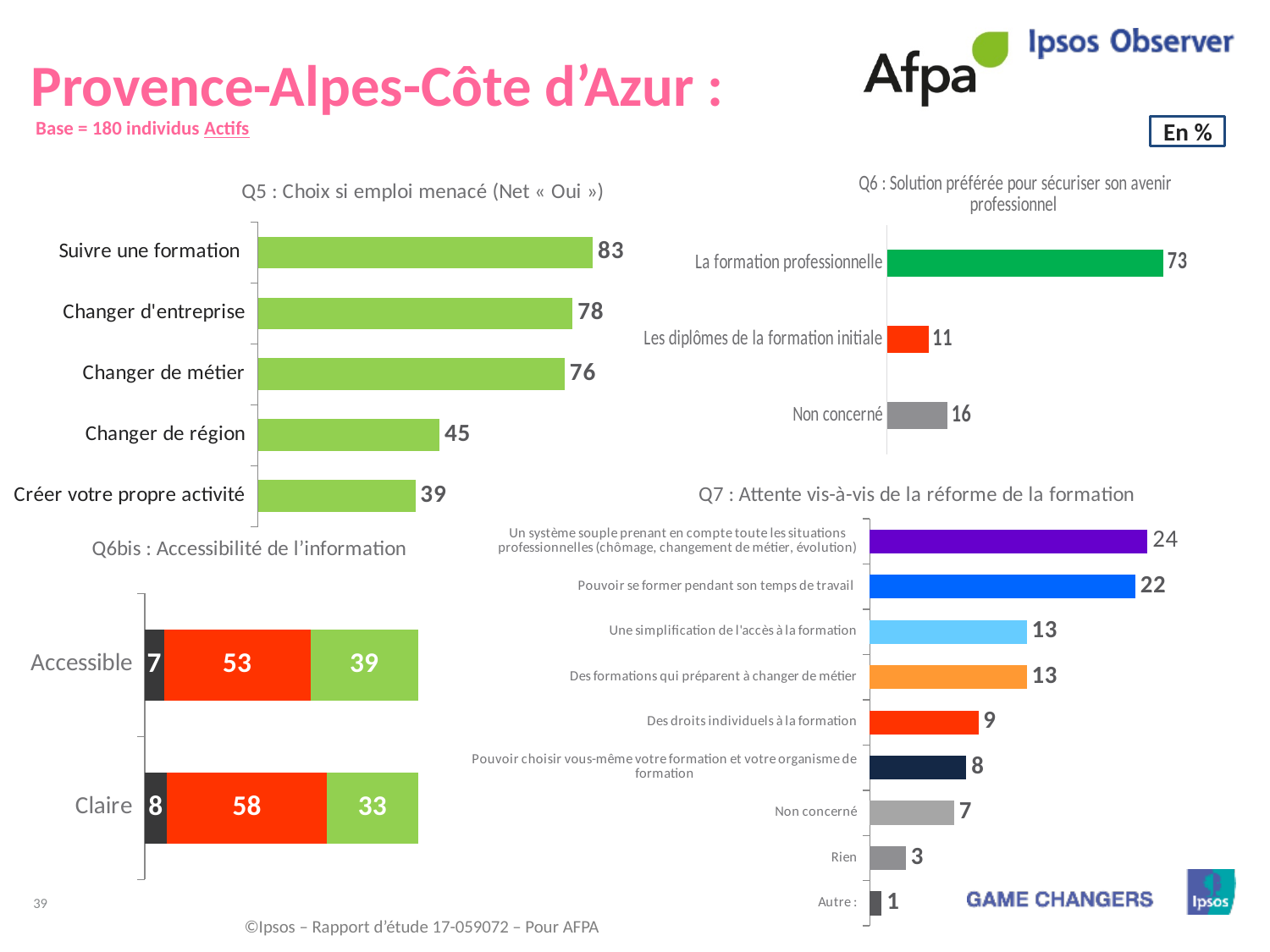
In the Q7 chart (Attente vis-à-vis de la réforme de la formation), what is the value for Des droits individuels à la formation? 9 In the Q6 chart (Solution préférée pour sécuriser son avenir professionnel), what is the value for Non concerné? 16 In the Q6 chart (Solution préférée pour sécuriser son avenir professionnel), which category has the lowest value? Les diplômes de la formation initiale In the Q6bis chart (Accessibilité de l'information), what is the value of the green segment for Claire? 33 In the Q7 chart (Attente vis-à-vis de la réforme de la formation), how many categories are shown? 9 In the Q7 chart (Attente vis-à-vis de la réforme de la formation), which is larger: Pouvoir se former pendant son temps de travail or Une simplification de l'accès à la formation? Pouvoir se former pendant son temps de travail In the Q6bis chart (Accessibilité de l'information), what is the total of the stacked bar for Accessible? 99 In the Q5 chart (Choix si emploi menacé), how many categories are shown? 5 What kind of chart is the Q5 chart (Choix si emploi menacé)? Bar chart In the Q5 chart (Choix si emploi menacé), which category has the highest value? Suivre une formation In the Q5 chart (Choix si emploi menacé), what is the difference between Suivre une formation and Créer votre propre activité? 44 In the Q5 chart (Choix si emploi menacé), what is the value for Changer de région? 45